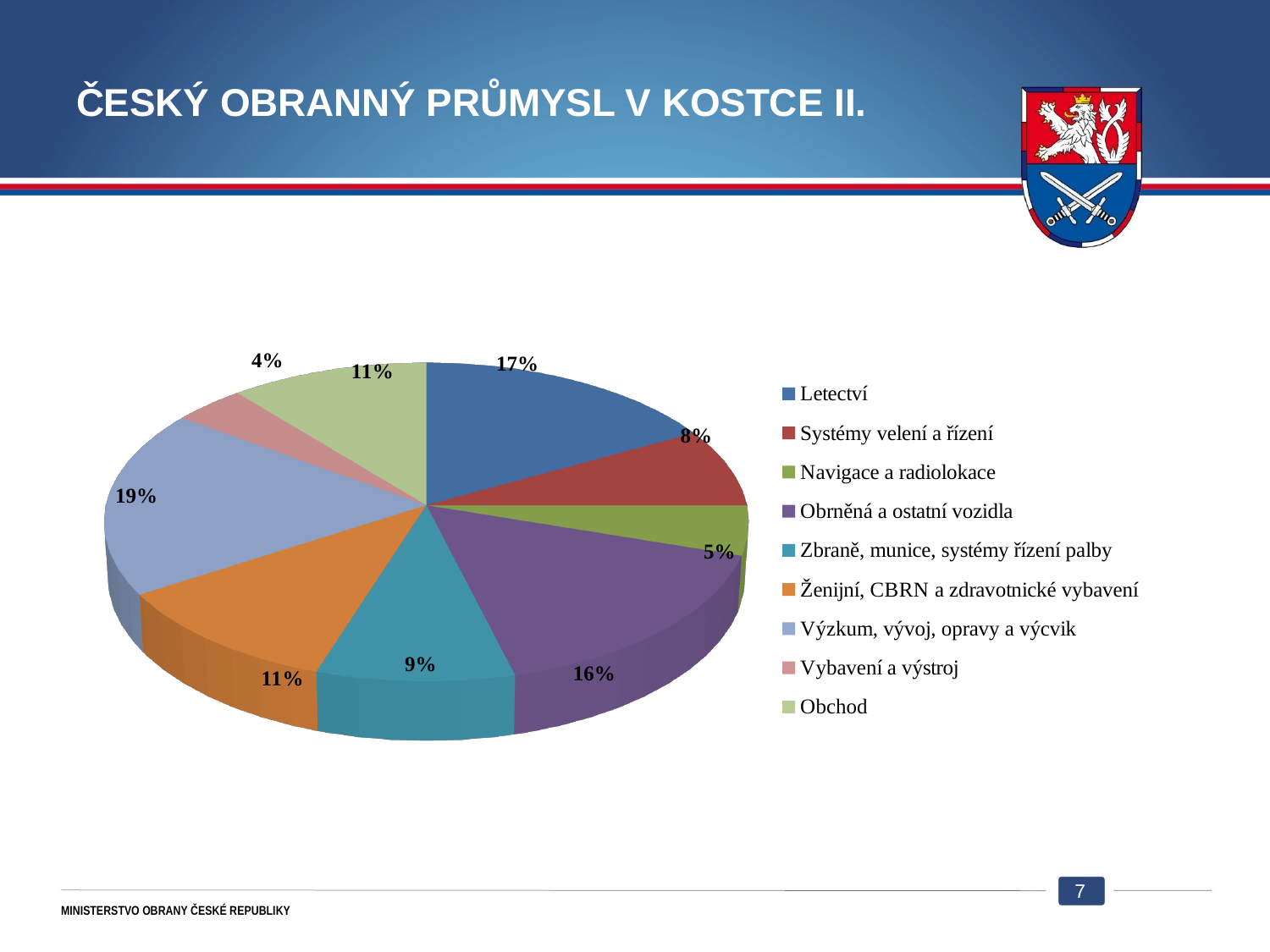
What share of the pie does Letectví have? 17% What share of the pie does Výzkum, vývoj, opravy a výcvik have? 19% How many categories does the pie chart show? 9 What share of the pie does Navigace a radiolokace have? 5% Which category has the smallest slice of the pie? Vybavení a výstroj What kind of chart is shown on the slide? Pie chart What is the difference in percentage points between Letectví and Systémy velení a řízení? 9 What share of the pie does Obrněná a ostatní vozidla have? 16% Which category is shown in orange in the legend? Ženijní, CBRN a zdravotnické vybavení What is the combined share of Ženijní, CBRN a zdravotnické vybavení and Obchod? 22% Which is larger, the share for Zbraně, munice, systémy řízení palby or the share for Obchod? Obchod Which category has the largest slice of the pie? Výzkum, vývoj, opravy a výcvik